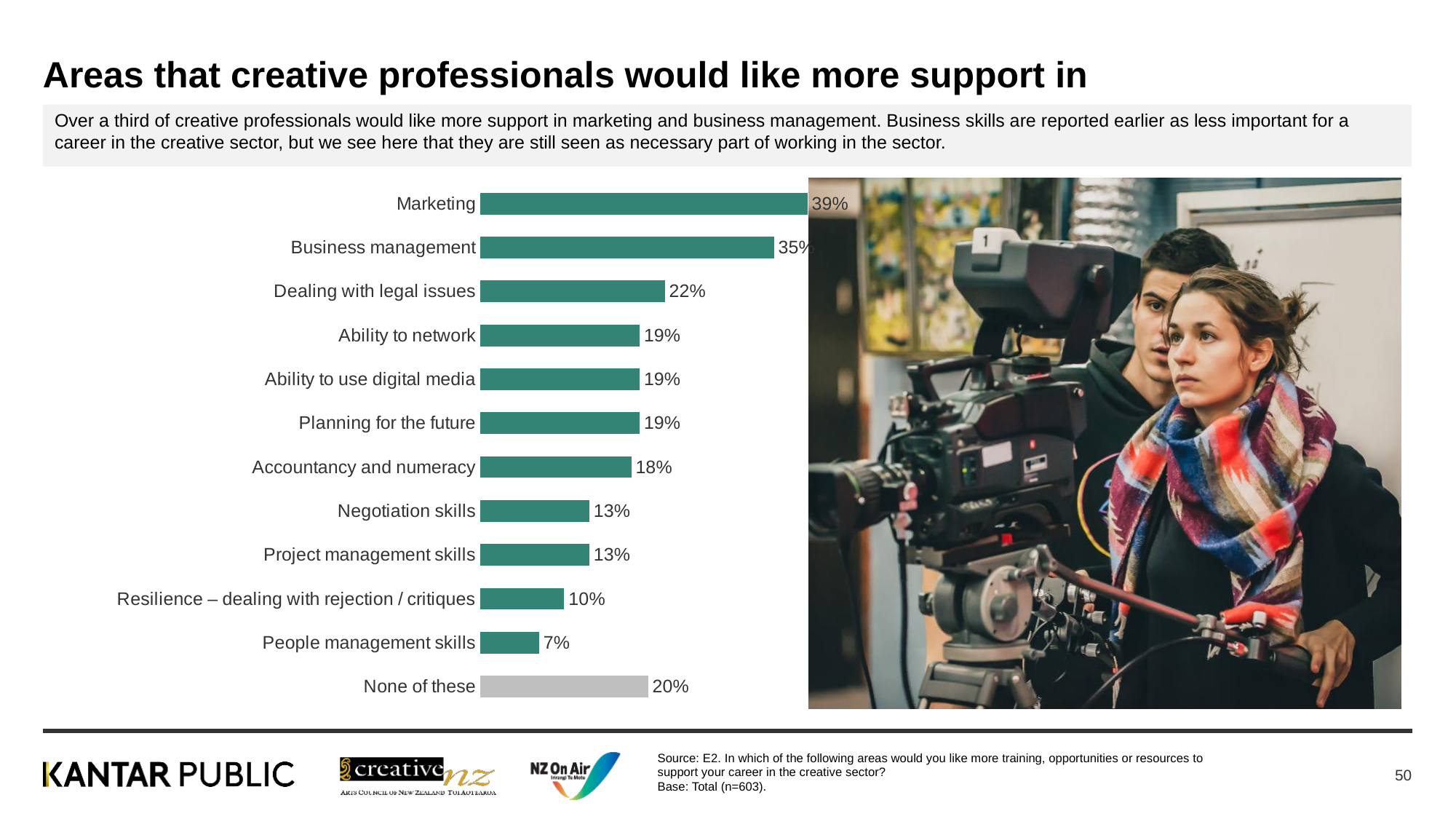
Which area has the lowest percentage in the chart? People management skills What percentage of creative professionals would like more support in Marketing? 39% What is the value for None of these? 20% What is the value shown for Dealing with legal issues? 22% Which bar in the chart is coloured grey rather than green? None of these What is the difference in percentage points between Marketing and Business management? 4 What kind of chart is shown on the slide? Bar chart How many categories are shown in the chart? 12 Which area has the highest percentage of creative professionals wanting more support? Marketing What is the difference in percentage points between Accountancy and numeracy and Negotiation skills? 5 What percentage is shown for People management skills? 7% Which is larger, the value for Dealing with legal issues or the value for Ability to network? Dealing with legal issues